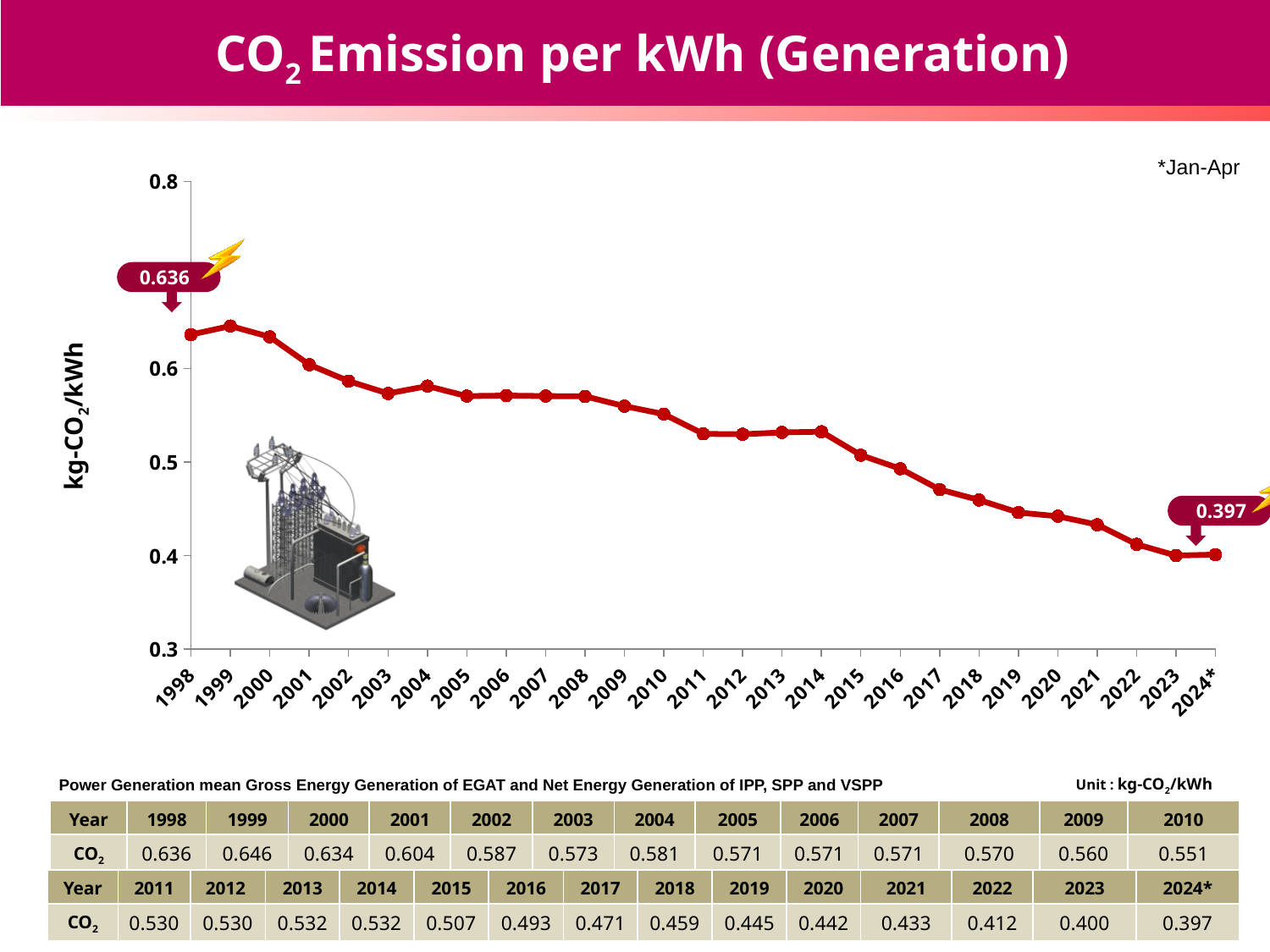
Is the value for 2022 greater or less than 0.5? less Which year has a higher CO2 emission per kWh, 2010 or 2015? 2010 What is the difference between the CO2 emission per kWh in 1998 and in 2024*? 0.239 What is the CO2 emission per kWh for 2024*? 0.397 What is the CO2 emission per kWh for 2014? 0.532 Which year has the lowest CO2 emission per kWh? 2024* What kind of chart is shown on the slide? line chart Which year has the highest CO2 emission per kWh? 1999 What is the label on the y axis of the chart? kg-CO2/kWh Do the values generally rise or fall from 1998 to 2024*? fall How many years are plotted on the chart? 27 What is the CO2 emission per kWh for 1998? 0.636